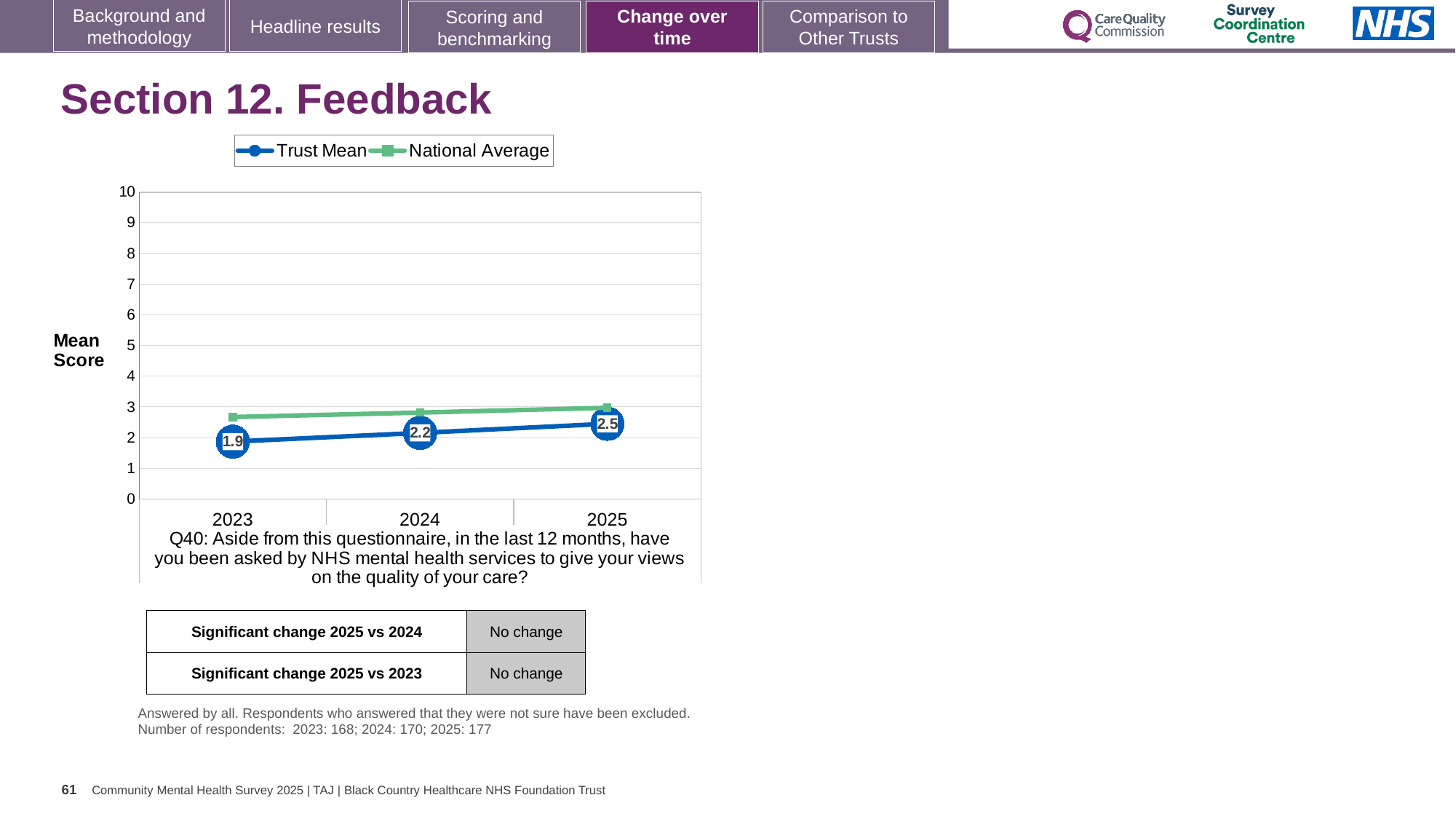
Is the National Average value for 2023 greater or less than 3? less What is the Trust Mean score for 2023? 1.9 How many series does the legend list? 2 What is the Trust Mean score for 2025? 2.5 How many years are plotted on the x axis? 3 What is the difference between the Trust Mean score in 2025 and in 2023? 0.6 What kind of chart is shown on the slide? Line chart In 2023, which is higher: the Trust Mean or the National Average? National Average What is the Trust Mean score for 2024? 2.2 Does the Trust Mean score rise or fall from 2023 to 2025? Rise In which year is the Trust Mean score lowest? 2023 In which year is the Trust Mean score highest? 2025